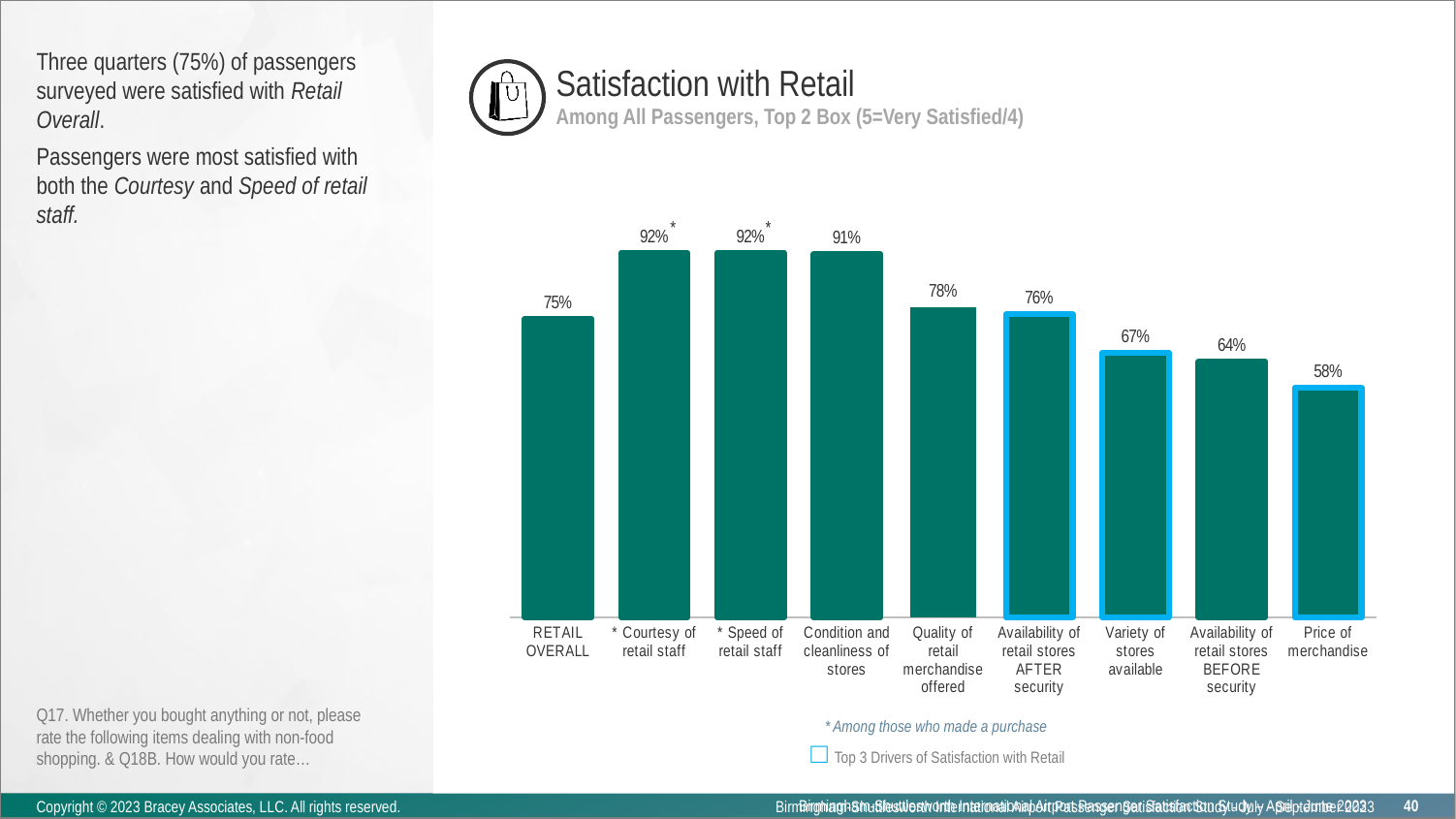
Which category has the lowest satisfaction value? Price of merchandise What is the difference between the satisfaction values for Courtesy of retail staff and RETAIL OVERALL? 17% Which is larger, the value for Availability of retail stores AFTER security or Availability of retail stores BEFORE security? Availability of retail stores AFTER security How many categories are shown in the chart? 9 What is the difference between the satisfaction values for Quality of retail merchandise offered and Variety of stores available? 11% How many bars are outlined in blue as Top 3 Drivers of Satisfaction with Retail? 3 What is the satisfaction value for Price of merchandise? 58% What is the title of the chart? Satisfaction with Retail What is the satisfaction value for Availability of retail stores AFTER security? 76% What is the satisfaction value for Condition and cleanliness of stores? 91% What is the satisfaction value for RETAIL OVERALL? 75% What kind of chart is shown on the slide? Bar chart